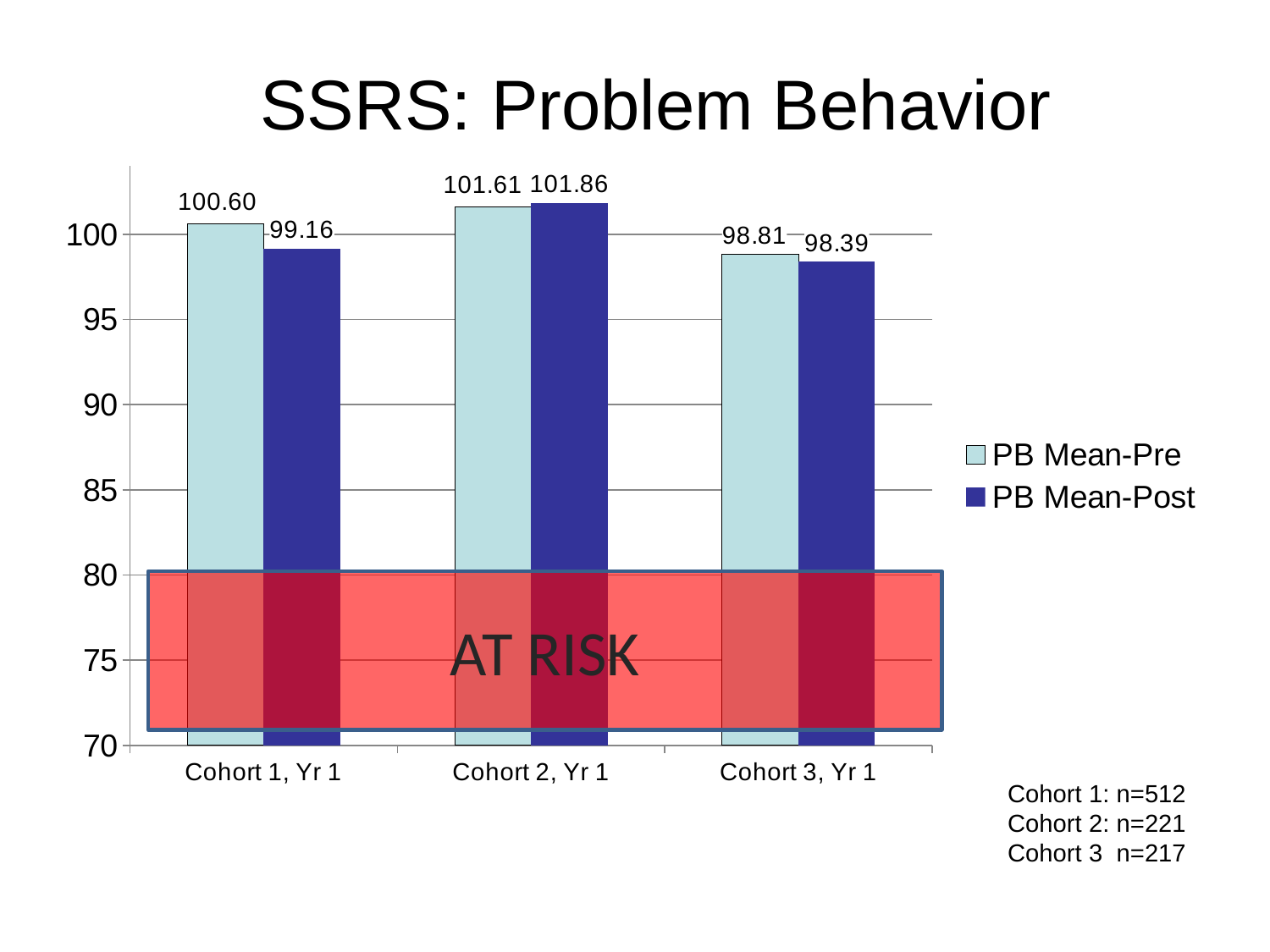
Which cohort has the lowest PB Mean-Post value? Cohort 3, Yr 1 What is the PB Mean-Post value for Cohort 3, Yr 1? 98.39 What is the difference between the PB Mean-Pre and PB Mean-Post values for Cohort 1, Yr 1? 1.44 What is the title of the chart? SSRS: Problem Behavior How many series does the legend list? 2 Which cohort has the highest PB Mean-Pre value? Cohort 2, Yr 1 What is the PB Mean-Pre value for Cohort 1, Yr 1? 100.60 What label appears in the red shaded band at the bottom of the chart? AT RISK For Cohort 3, Yr 1, which is larger: PB Mean-Pre or PB Mean-Post? PB Mean-Pre How many cohorts are shown on the x axis? 3 What kind of chart is shown on the slide? Bar chart What is the PB Mean-Post value for Cohort 2, Yr 1? 101.86